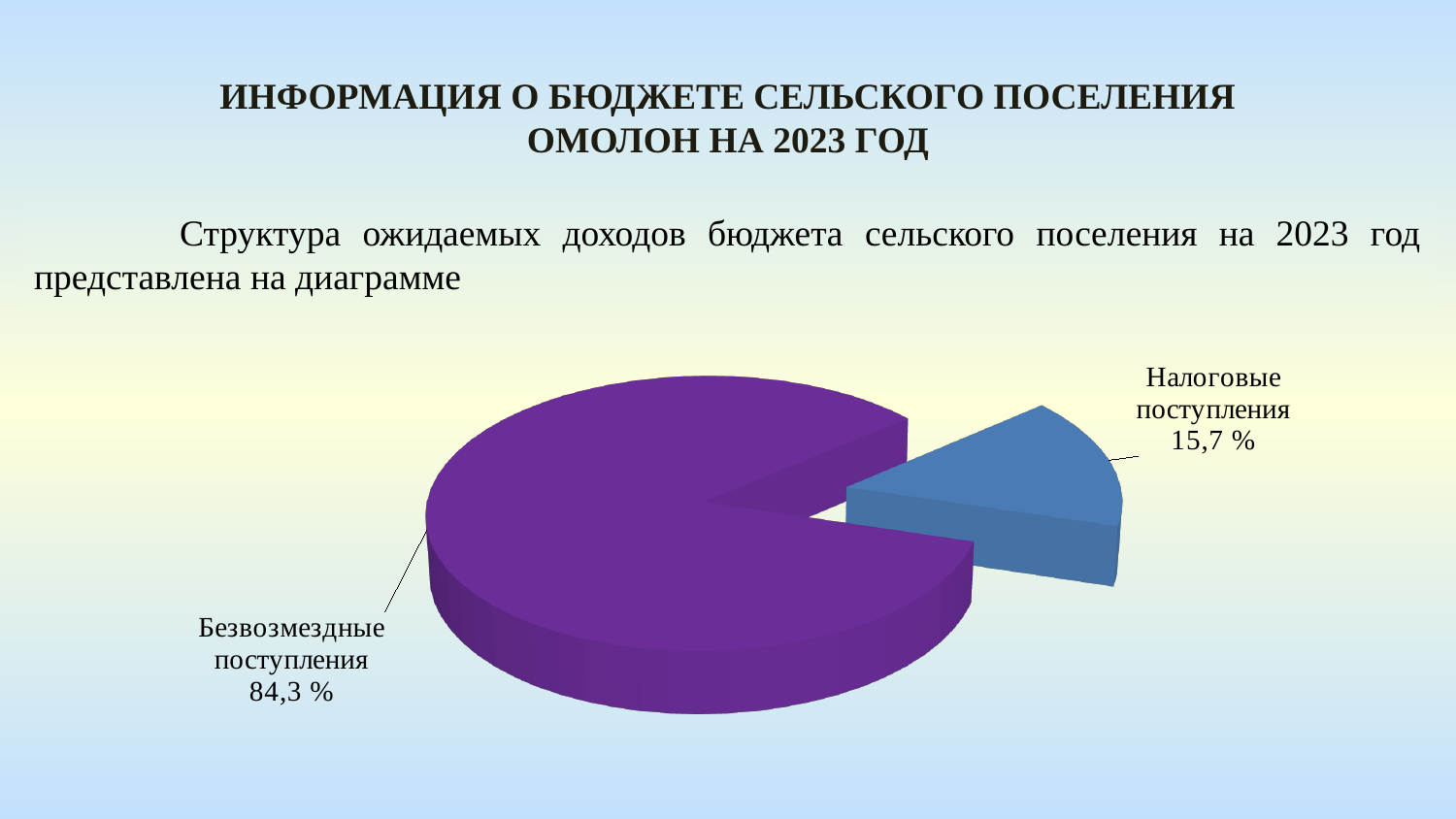
What kind of chart is shown on the slide? Pie chart Which slice of the pie is the largest? Безвозмездные поступления Which is larger: the share for "Налоговые поступления" or for "Безвозмездные поступления"? Безвозмездные поступления What share of the pie is labelled "Налоговые поступления"? 15,7 % What is the difference in percentage points between the "Безвозмездные поступления" and "Налоговые поступления" slices? 68,6 What colour is the "Налоговые поступления" slice? Blue How many slices does the pie chart have? 2 Which slice of the pie is the smallest? Налоговые поступления What is the total of the two slice percentages shown on the pie chart? 100 % What colour is the "Безвозмездные поступления" slice? Purple What share of the pie is labelled "Безвозмездные поступления"? 84,3 %